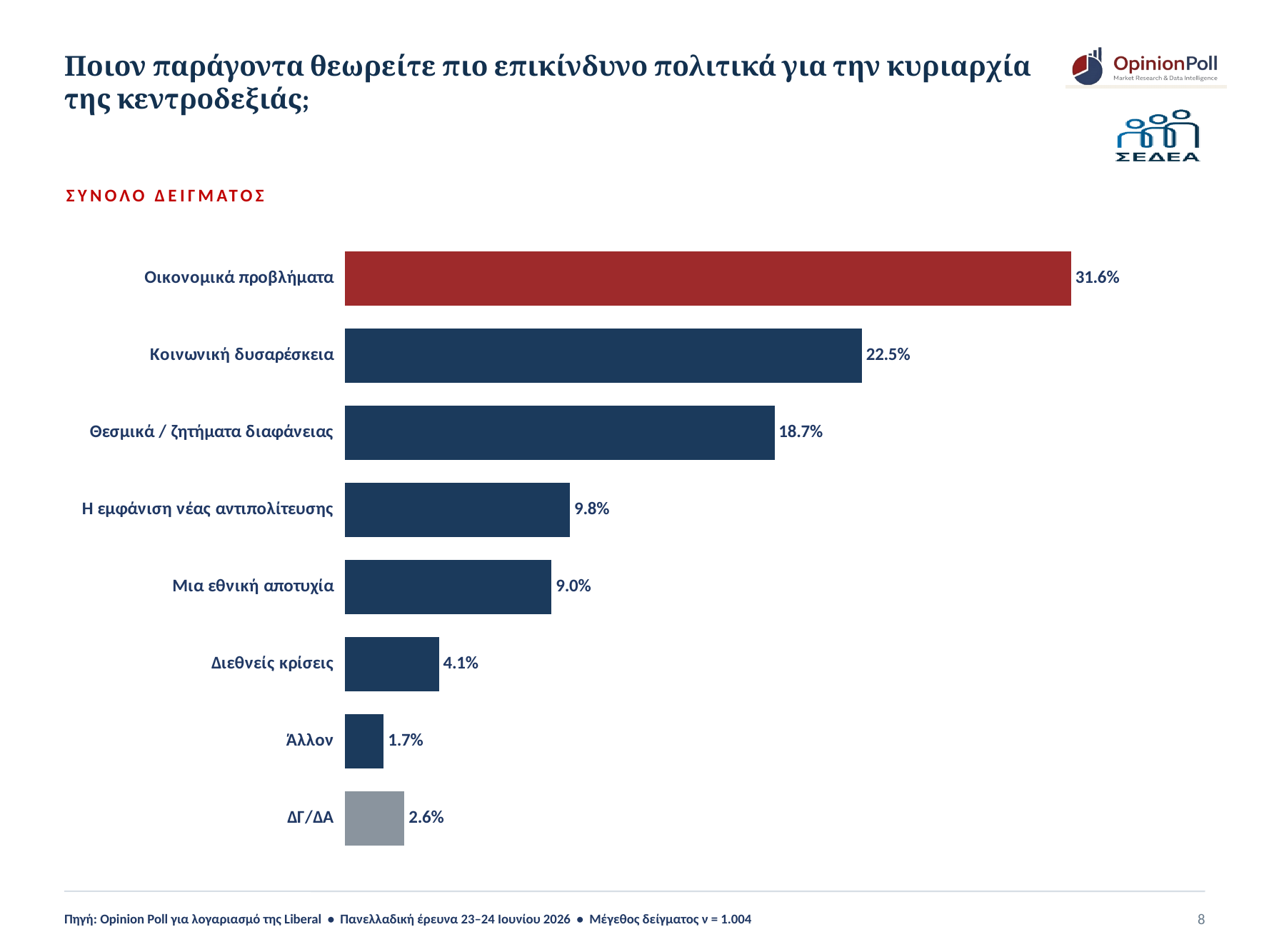
What is the value for Κοινωνική δυσαρέσκεια? 22.5% What is the difference between the values for Οικονομικά προβλήματα and Κοινωνική δυσαρέσκεια? 9.1 percentage points What is the value for ΔΓ/ΔΑ? 2.6% How many categories are shown in the chart? 8 Which category's bar is coloured red? Οικονομικά προβλήματα What kind of chart is shown on the slide? Bar chart What value is labelled on the bar for Θεσμικά / ζητήματα διαφάνειας? 18.7% What percentage is shown for Διεθνείς κρίσεις? 4.1% Which category has the highest value? Οικονομικά προβλήματα What percentage is shown for Οικονομικά προβλήματα? 31.6% Which category has the lowest value? Άλλον Which is larger, the value for Η εμφάνιση νέας αντιπολίτευσης or the value for Μια εθνική αποτυχία? Η εμφάνιση νέας αντιπολίτευσης